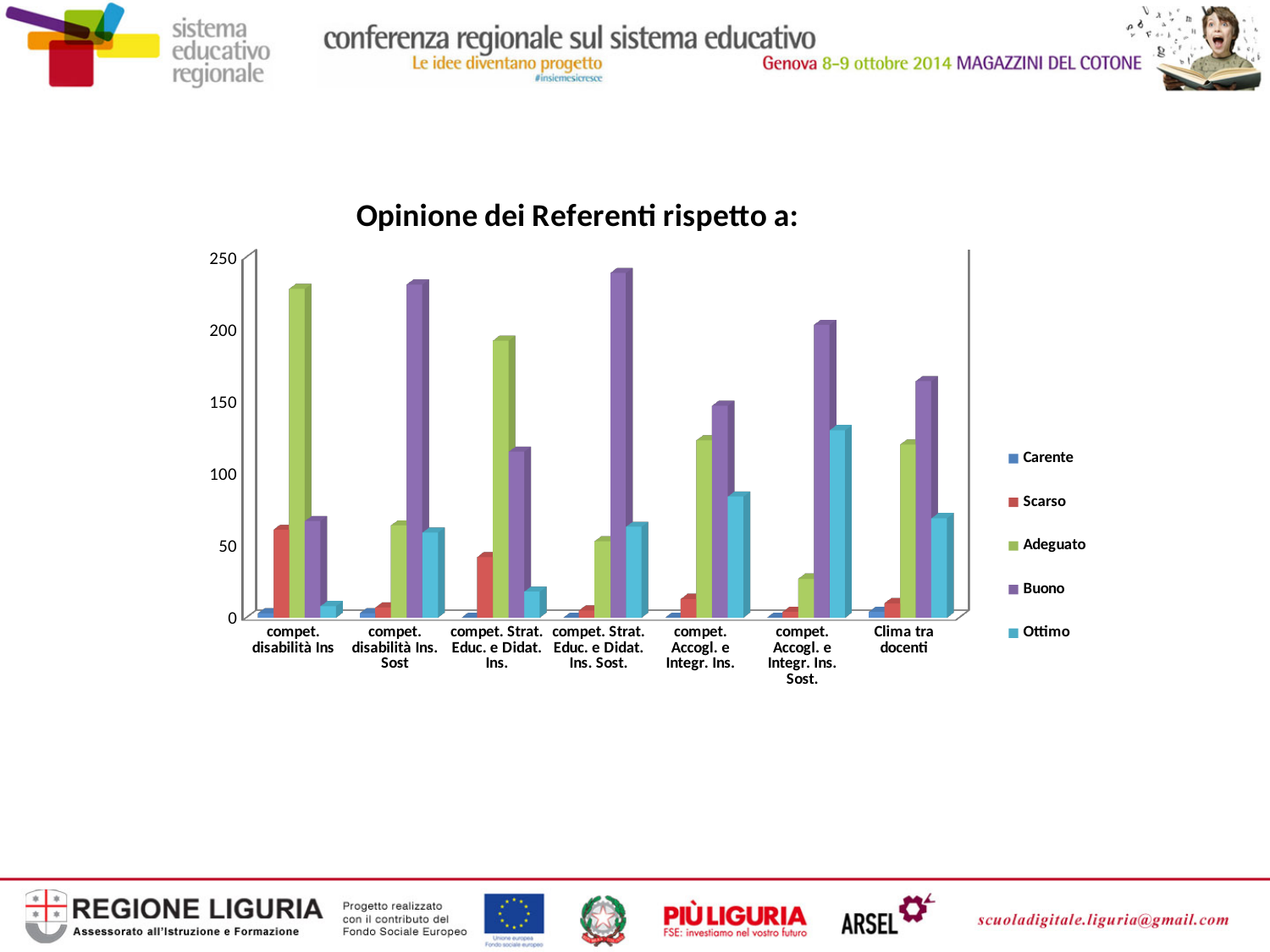
Is the Ottimo value for compet. Accogl. e Integr. Ins. Sost. greater or less than 100? greater Is the Adeguato value for compet. disabilità Ins greater or less than 200? greater What is the title of the chart? Opinione dei Referenti rispetto a: For Clima tra docenti, which series has the highest value? Buono Is the Buono value for compet. Strat. Educ. e Didat. Ins. Sost. greater or less than 200? greater How many categories are shown on the x axis? 7 For compet. Accogl. e Integr. Ins., which is larger: the Buono value or the Ottimo value? Buono What type of chart is shown on the slide? bar chart Which series is shown in purple in the legend? Buono For compet. disabilità Ins, which series has the highest value? Adeguato How many series does the legend list? 5